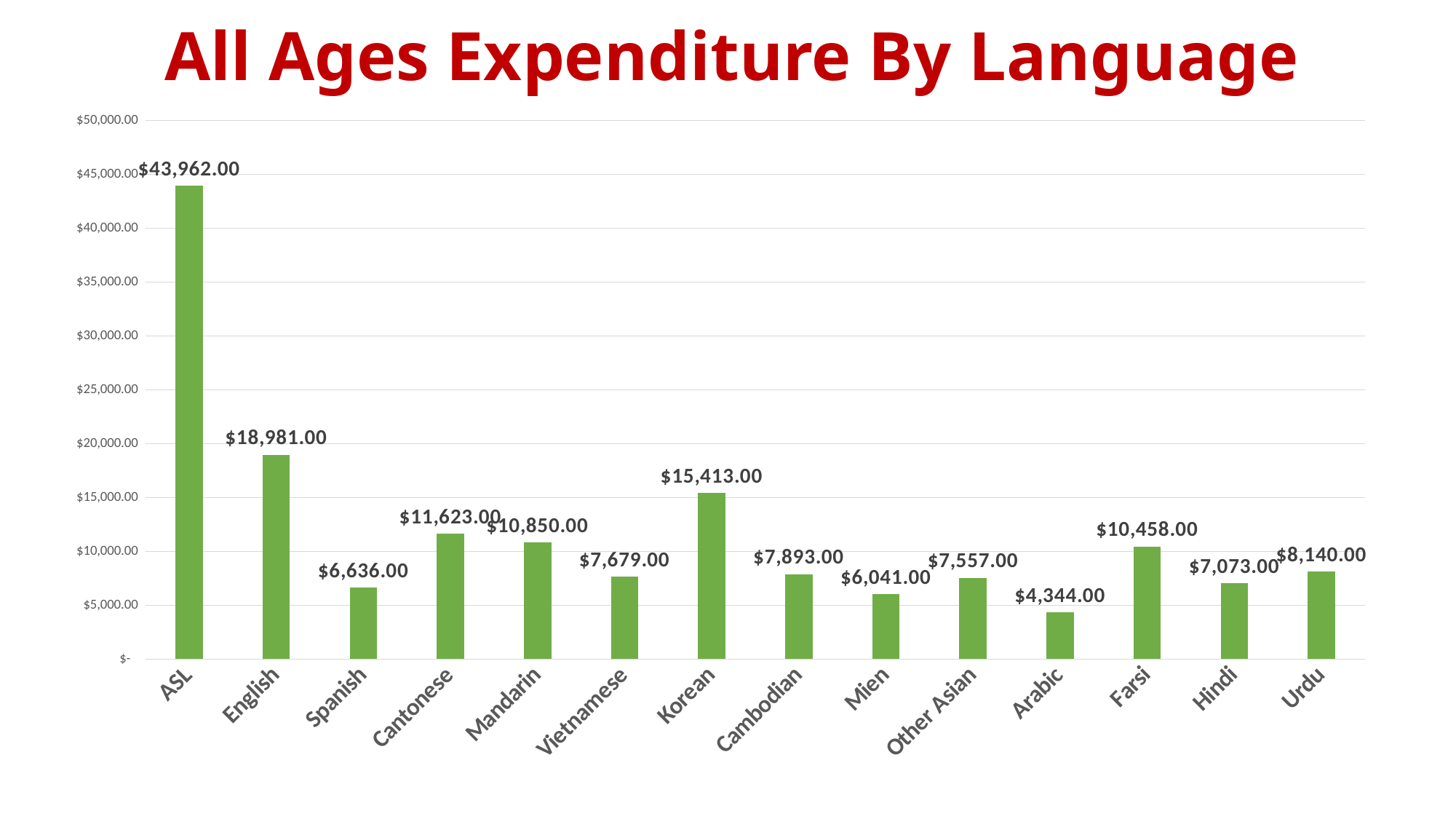
What kind of chart is shown on the slide? bar chart What is the difference between the expenditure for Korean and Cantonese? $3,790.00 How many languages are shown on the chart? 14 Which language has the highest expenditure? ASL What is the title of the chart? All Ages Expenditure By Language What is the expenditure for ASL? $43,962.00 What is the expenditure for Korean? $15,413.00 Which has a larger expenditure, Mandarin or Farsi? Mandarin What is the expenditure for Farsi? $10,458.00 Is the expenditure for English greater or less than $15,000.00? greater What is the difference between the expenditure for ASL and English? $24,981.00 Which language has the lowest expenditure? Arabic